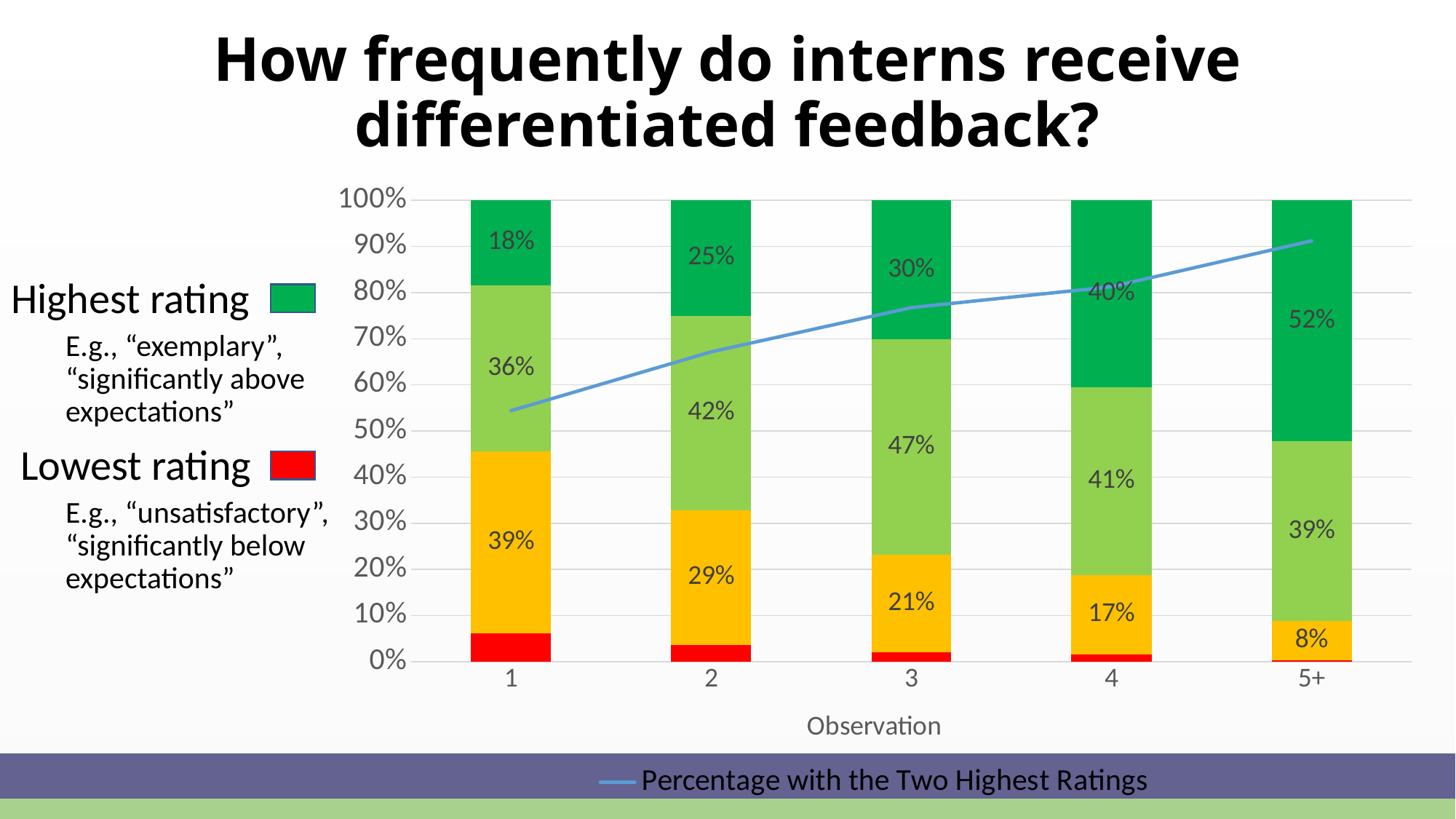
What percentage of interns received the highest rating (dark green segment) at observation 5+? 52% Does the highest rating (dark green) share rise or fall as the observation number increases? rises What is the value of the yellow segment for observation 3? 21% How many observation categories are shown on the x axis? 5 What percentage of interns received the highest rating (dark green segment) at observation 1? 18% At which observation is the highest rating (dark green) share the largest? 5+ Is the 'Percentage with the Two Highest Ratings' line at observation 1 greater or less than 50%? greater Is the red (lowest rating) segment at observation 1 greater or less than 10%? less At which observation is the yellow segment the smallest? 5+ Which is larger: the light green segment at observation 2 or at observation 3? Observation 3 What is the value of the light green segment for observation 4? 41% How much larger is the highest rating share at observation 5+ than at observation 1? 34 percentage points